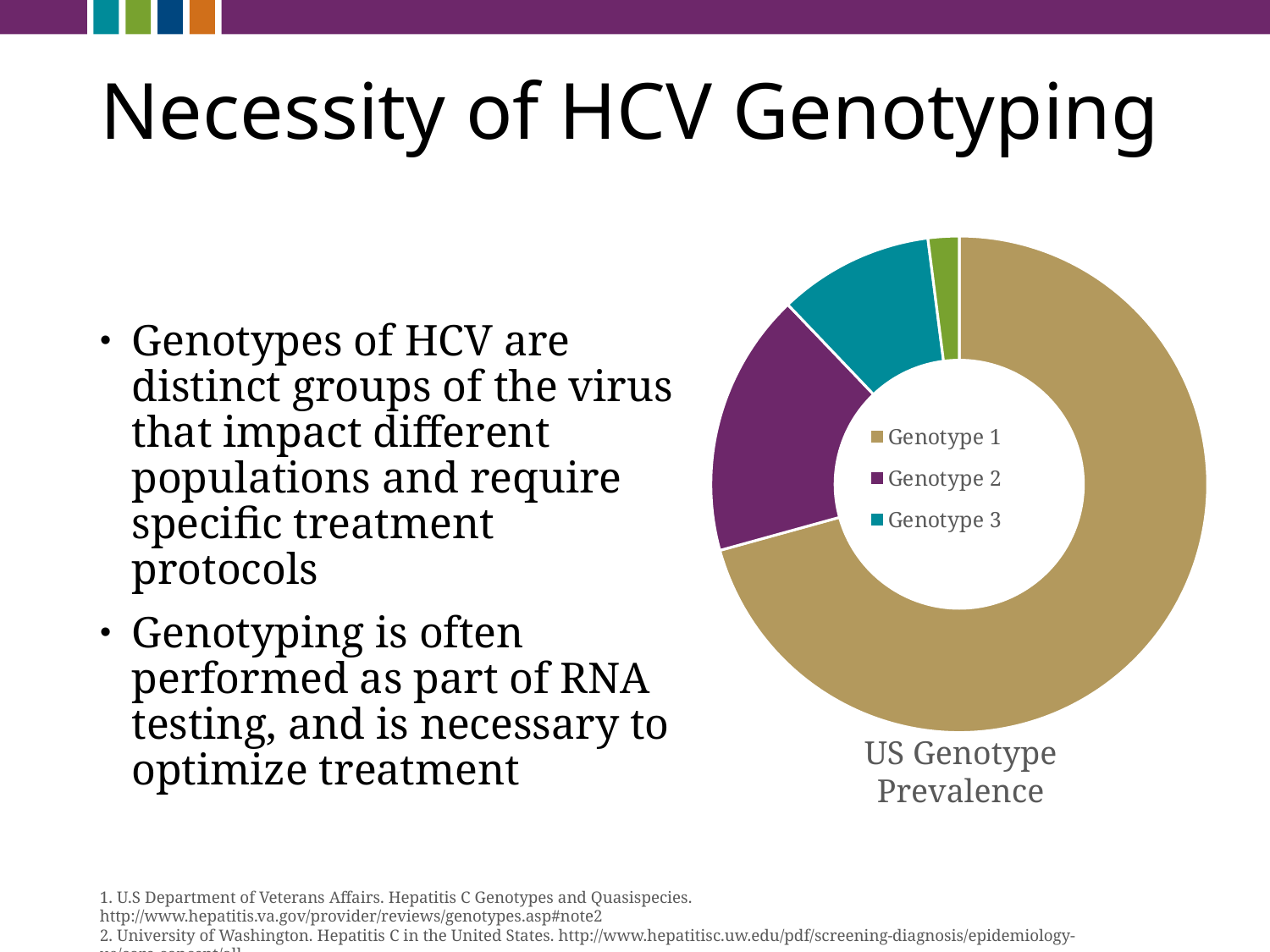
How many slices does the chart contain? 4 Which genotype has the largest share of the chart? Genotype 1 Which has the larger share, Genotype 1 or Genotype 2? Genotype 1 How many entries does the chart's legend list? 3 What is the title of the chart? US Genotype Prevalence What kind of chart is shown on the slide? Doughnut (pie) chart Which has the larger share, Genotype 2 or Genotype 3? Genotype 2 What colour represents Genotype 3 in the chart? Teal Does Genotype 1 account for more or less than half of the chart? More Of the genotypes named in the legend, which has the smallest share of the chart? Genotype 3